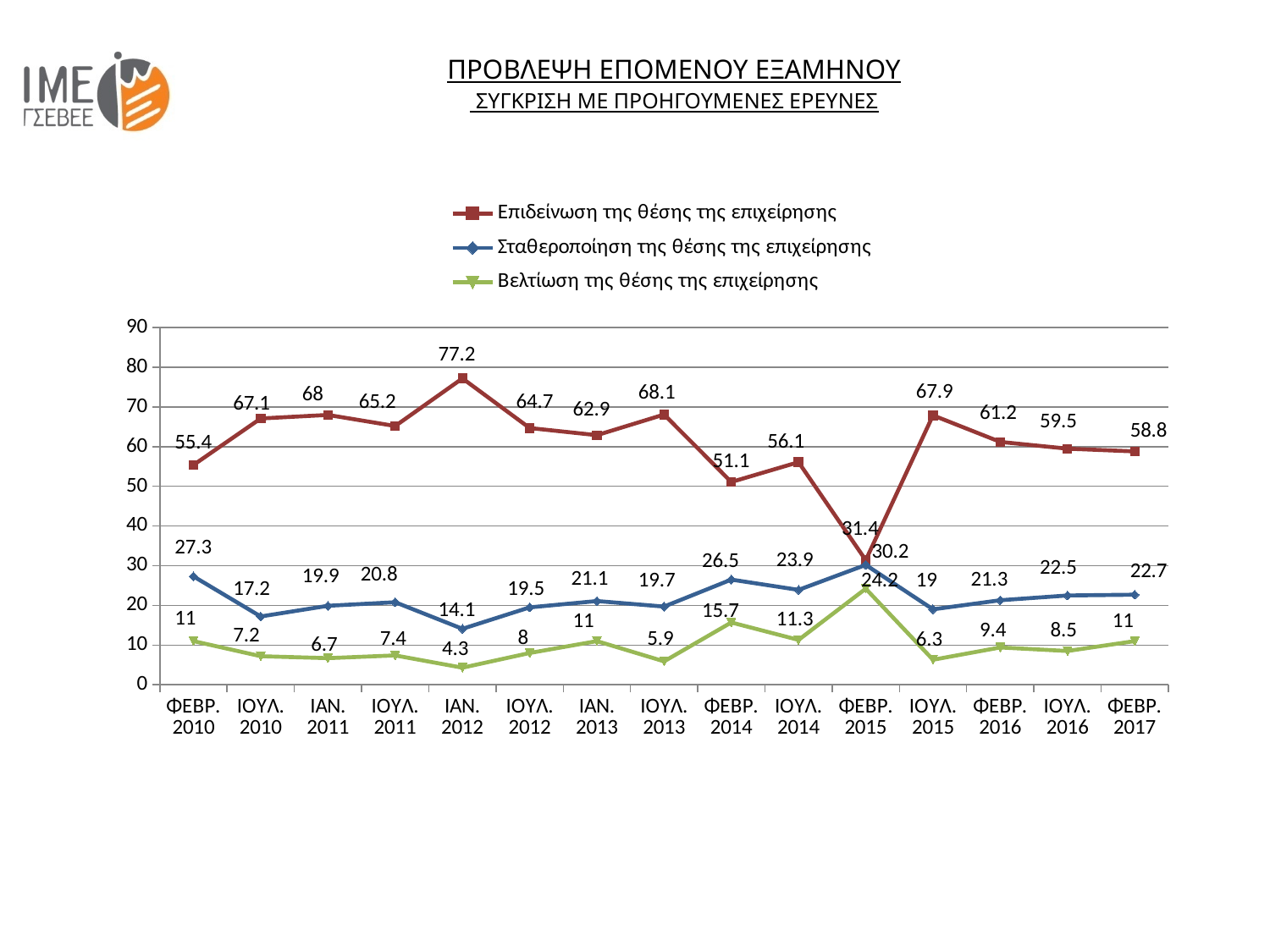
What type of chart is shown on the slide? line chart Does Επιδείνωση της θέσης της επιχείρησης rise or fall from ΙΟΥΛ. 2015 to ΦΕΒΡ. 2017? fall In which period does Βελτίωση της θέσης της επιχείρησης reach its highest value? ΦΕΒΡ. 2015 What is the value of Βελτίωση της θέσης της επιχείρησης for ΦΕΒΡ. 2017? 11 What is the value of Επιδείνωση της θέσης της επιχείρησης for ΙΑΝ. 2012? 77.2 What is the value of Σταθεροποίηση της θέσης της επιχείρησης for ΦΕΒΡ. 2010? 27.3 What is the difference between the Επιδείνωση values for ΙΟΥΛ. 2015 and ΦΕΒΡ. 2017? 9.1 In which period does Βελτίωση της θέσης της επιχείρησης reach its lowest value? ΙΑΝ. 2012 In which period does Επιδείνωση της θέσης της επιχείρησης reach its highest value? ΙΑΝ. 2012 How many series does the legend list? 3 Which is larger for ΙΟΥΛ. 2014: Σταθεροποίηση της θέσης της επιχείρησης or Βελτίωση της θέσης της επιχείρησης? Σταθεροποίηση της θέσης της επιχείρησης How many survey periods are plotted along the x axis? 15